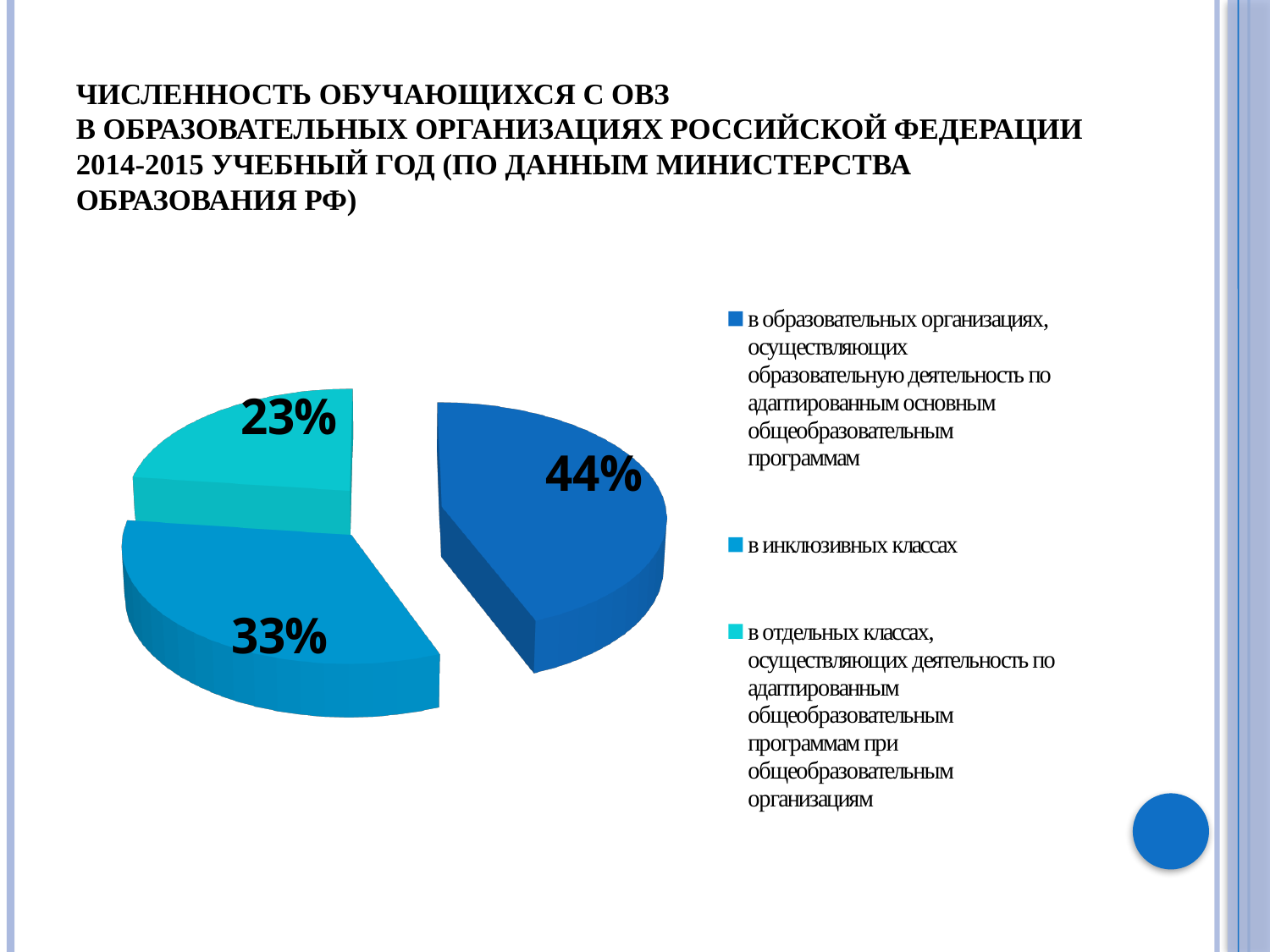
What is the difference in percentage points between the 44% slice and the 33% slice? 11 What percentage is shown for the slice "в образовательных организациях, осуществляющих образовательную деятельность по адаптированным основным общеобразовательным программам"? 44% What percentage is shown for the slice "в отдельных классах, осуществляющих деятельность по адаптированным общеобразовательным программам при общеобразовательным организациям"? 23% What share of the pie is labelled for "в инклюзивных классах"? 33% What kind of chart is shown on the slide? pie chart Which category has the largest share of the pie? в образовательных организациях, осуществляющих образовательную деятельность по адаптированным основным общеобразовательным программам Which is larger: the share for "в инклюзивных классах" or the share for "в отдельных классах"? в инклюзивных классах What school year does the chart title refer to? 2014-2015 How many slices does the pie chart have? 3 What is the difference in percentage points between the largest slice (44%) and the smallest slice (23%)? 21 Which category has the smallest share of the pie? в отдельных классах, осуществляющих деятельность по адаптированным общеобразовательным программам при общеобразовательным организациям How many entries does the legend of the pie chart list? 3